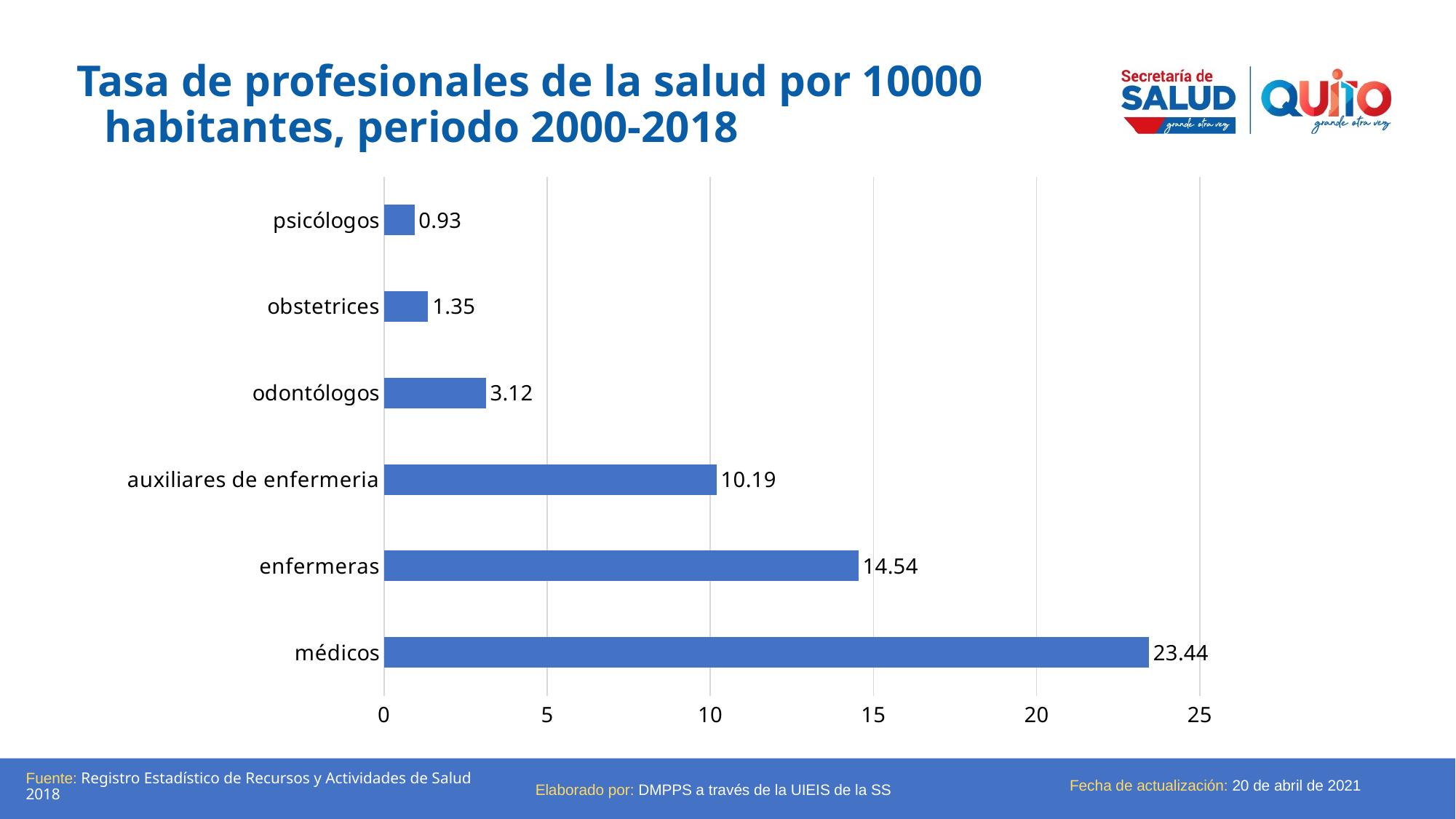
Which category has the highest rate? médicos What is the rate for psicólogos? 0.93 Is the value for auxiliares de enfermeria greater or less than 10? greater What is the title of the slide? Tasa de profesionales de la salud por 10000 habitantes, periodo 2000-2018 Which category has the lowest rate? psicólogos What is the difference between the rates for médicos and enfermeras? 8.90 Which is larger, the rate for odontólogos or the rate for obstetrices? odontólogos How many categories are shown in the chart? 6 What is the rate for enfermeras? 14.54 What is the rate for médicos? 23.44 What is the rate for auxiliares de enfermeria? 10.19 What kind of chart is shown on the slide? bar chart